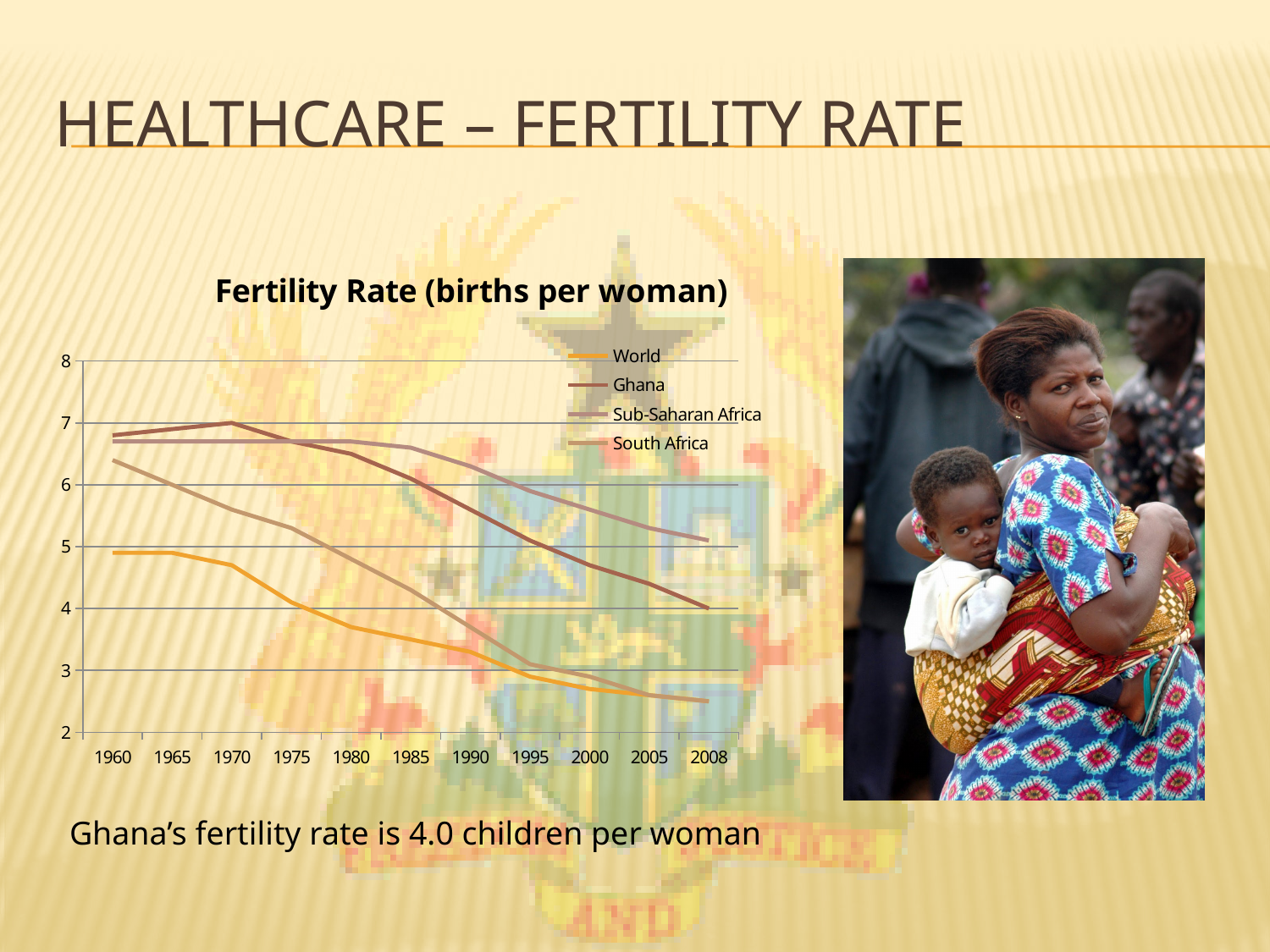
Is the Sub-Saharan Africa fertility rate in 1960 greater or less than 6? greater Does the Ghana fertility rate rise or fall from 1970 to 2008? fall Is the South Africa fertility rate in 2008 greater or less than 3? less Which series in the chart is drawn in orange? World In 1960, which is higher: the World fertility rate or the South Africa fertility rate? South Africa How many years are marked along the x axis of the Fertility Rate chart? 11 What is the title of the chart? Fertility Rate (births per woman) What kind of chart is shown on the slide? line chart How many series does the legend of the Fertility Rate chart list? 4 In 2008, which series has the highest fertility rate? Sub-Saharan Africa What is Ghana's fertility rate in 2008 according to the chart? 4.0